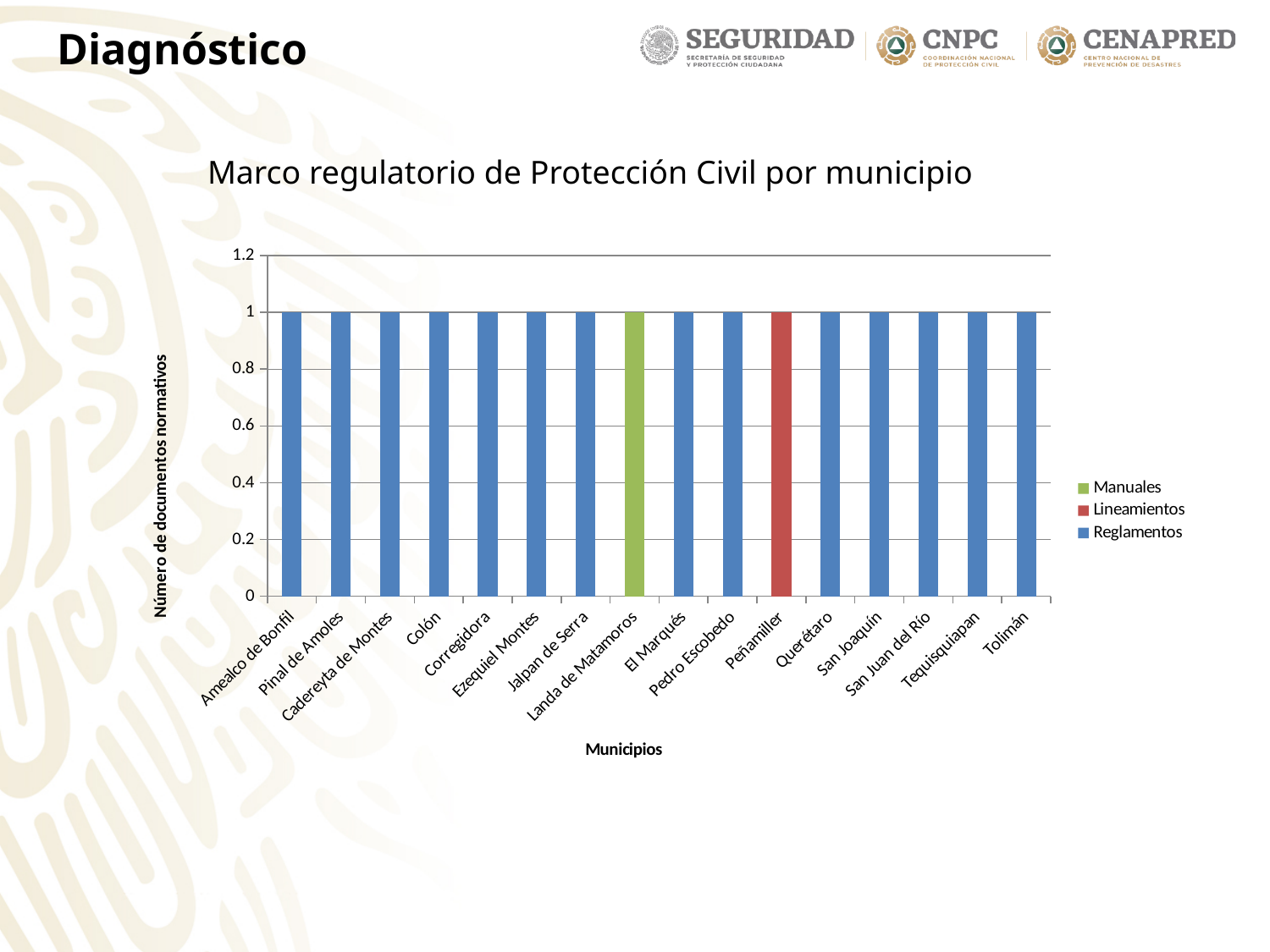
How many series does the legend list? 3 How many municipalities are shown on the x axis? 16 Which series does the bar for Landa de Matamoros belong to, according to the legend colours? Manuales What is the value for Landa de Matamoros? 1 What is the value for Querétaro? 1 What is the difference between the values for Amealco de Bonfil and San Joaquín? 0 What is the value for Peñamiller? 1 What type of chart is shown on the slide? Bar chart Do the values rise, fall, or stay the same across the municipalities on the x axis? Stay the same What is the title of the chart? Marco regulatorio de Protección Civil por municipio Is the value for Colón greater or less than 1.2? less Is the value for Tolimán greater or less than 0.8? greater